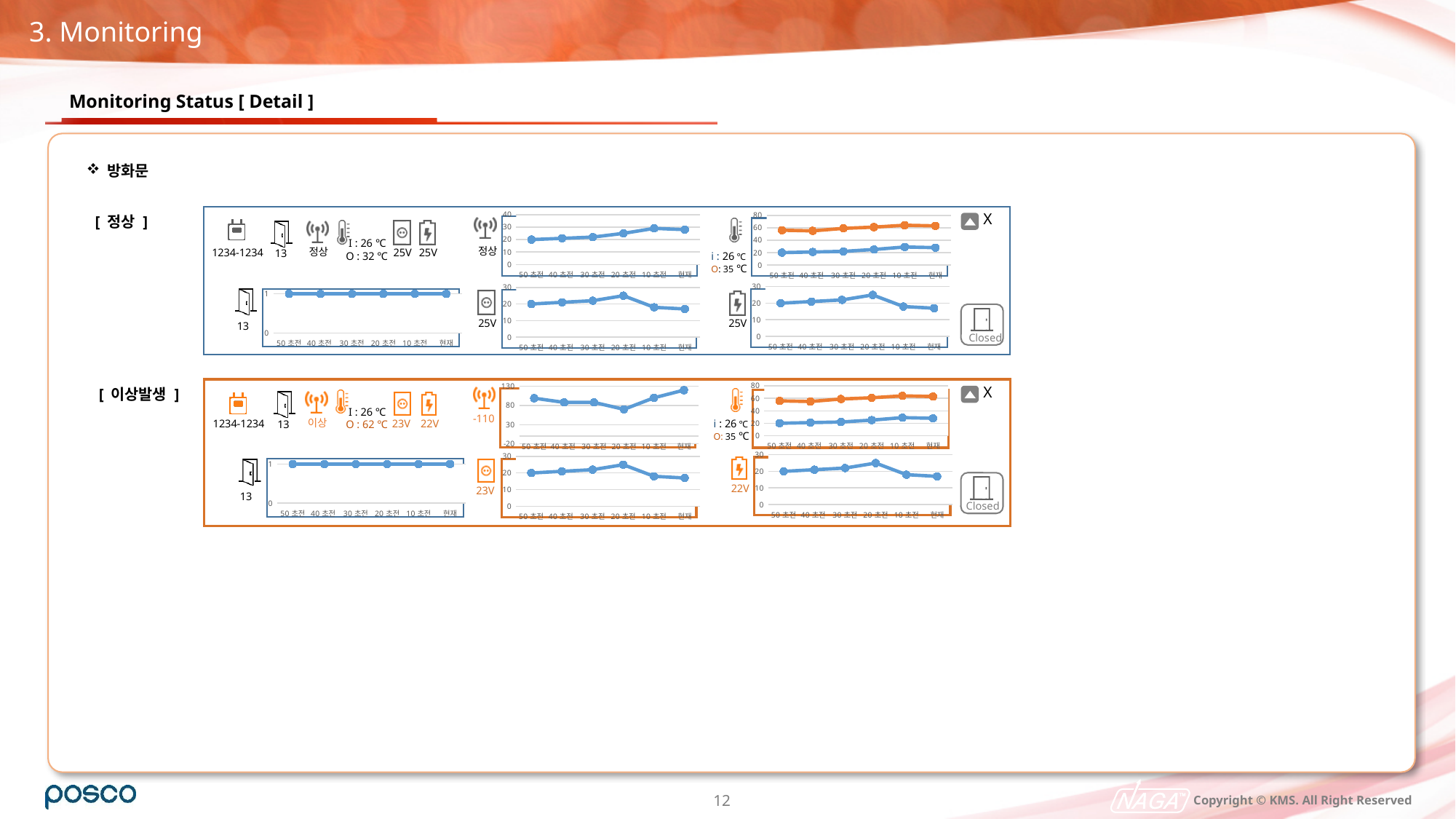
In the 정상 panel, does the line in the bottom-left door chart rise, fall, or stay flat across the x axis? stay flat In the 정상 panel, how many lines are plotted in the top-right chart next to the thermometer icon? 2 What is the last x-axis label on the line charts in the 정상 panel? 현재 In the 이상발생 panel, at which x-axis point does the top-middle line chart reach its highest value? 현재 In the 정상 panel, in the top-right chart with two lines, which line is higher, the orange one or the blue one? orange In the 이상발생 panel, is the value at 현재 in the top-middle line chart greater or less than 80? greater In the 이상발생 panel, at which x-axis point does the top-middle line chart reach its lowest value? 20 초전 In the 정상 panel, is the value at 현재 in the bottom-middle line chart greater or less than 20? less In the 정상 panel, what kind of chart is the top-middle chart next to the signal icon? line chart In the 정상 panel, is the value at 현재 in the top-middle line chart greater or less than 20? greater In the 정상 panel, how many time points are plotted along the x axis of the top-middle line chart? 6 In the 정상 panel, at which x-axis point does the bottom-middle line chart reach its highest value? 20 초전